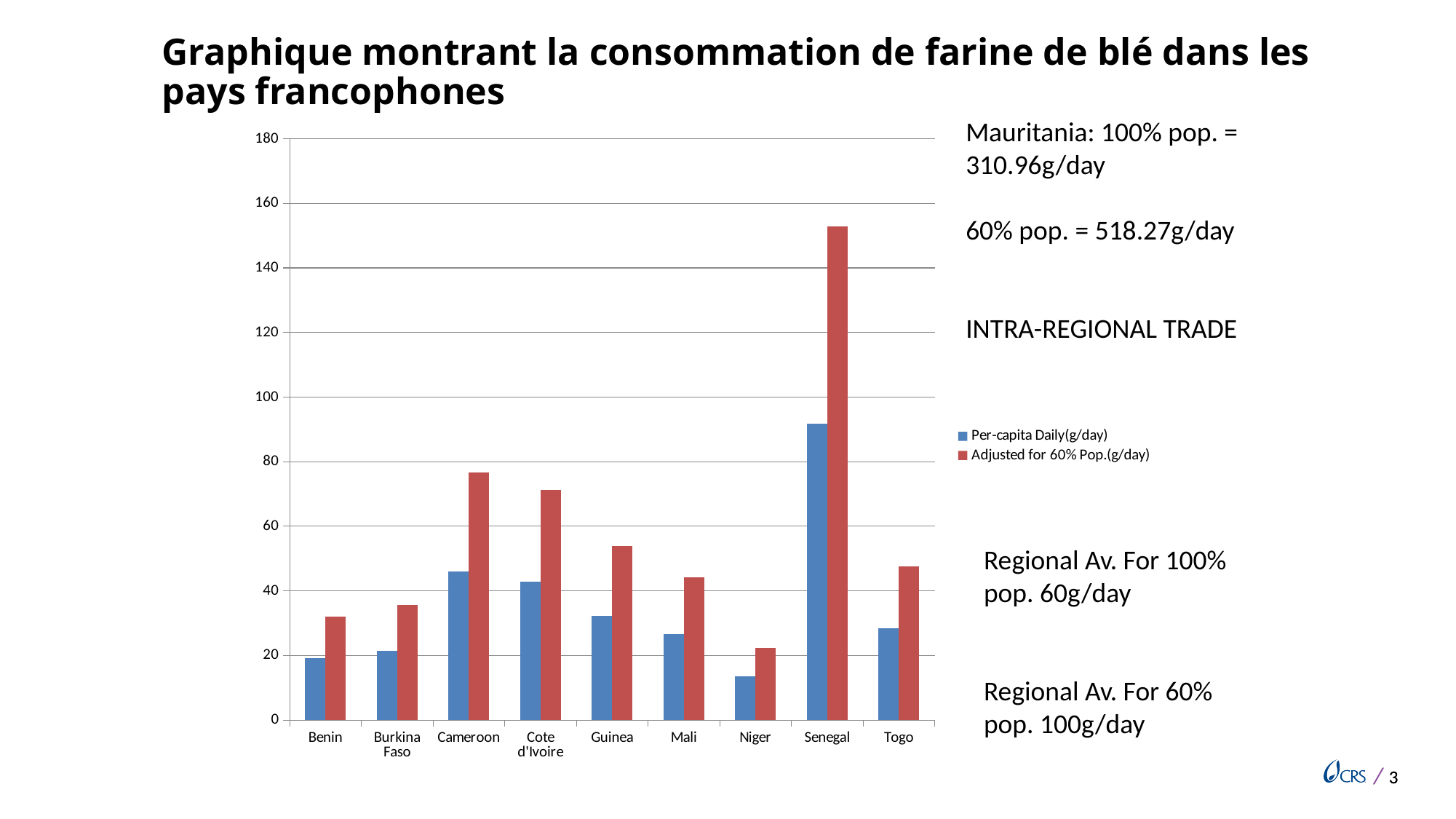
Is the Adjusted for 60% Pop.(g/day) value for Cameroon greater or less than 80? less Which is larger, the Adjusted for 60% Pop.(g/day) value for Benin or for Togo? Togo How many series does the chart legend list? 2 Which country has the highest Adjusted for 60% Pop.(g/day) value? Senegal Is the Per-capita Daily(g/day) value for Senegal greater or less than 100? less How many countries are shown on the x axis of the chart? 9 Is the Adjusted for 60% Pop.(g/day) value for Senegal greater or less than 140? greater What kind of chart is shown on the slide? bar chart Which country has the lowest Adjusted for 60% Pop.(g/day) value? Niger Which is larger, the Per-capita Daily(g/day) value for Guinea or for Mali? Guinea What colour are the bars for the Adjusted for 60% Pop.(g/day) series? red Which country has the lowest Per-capita Daily(g/day) value? Niger